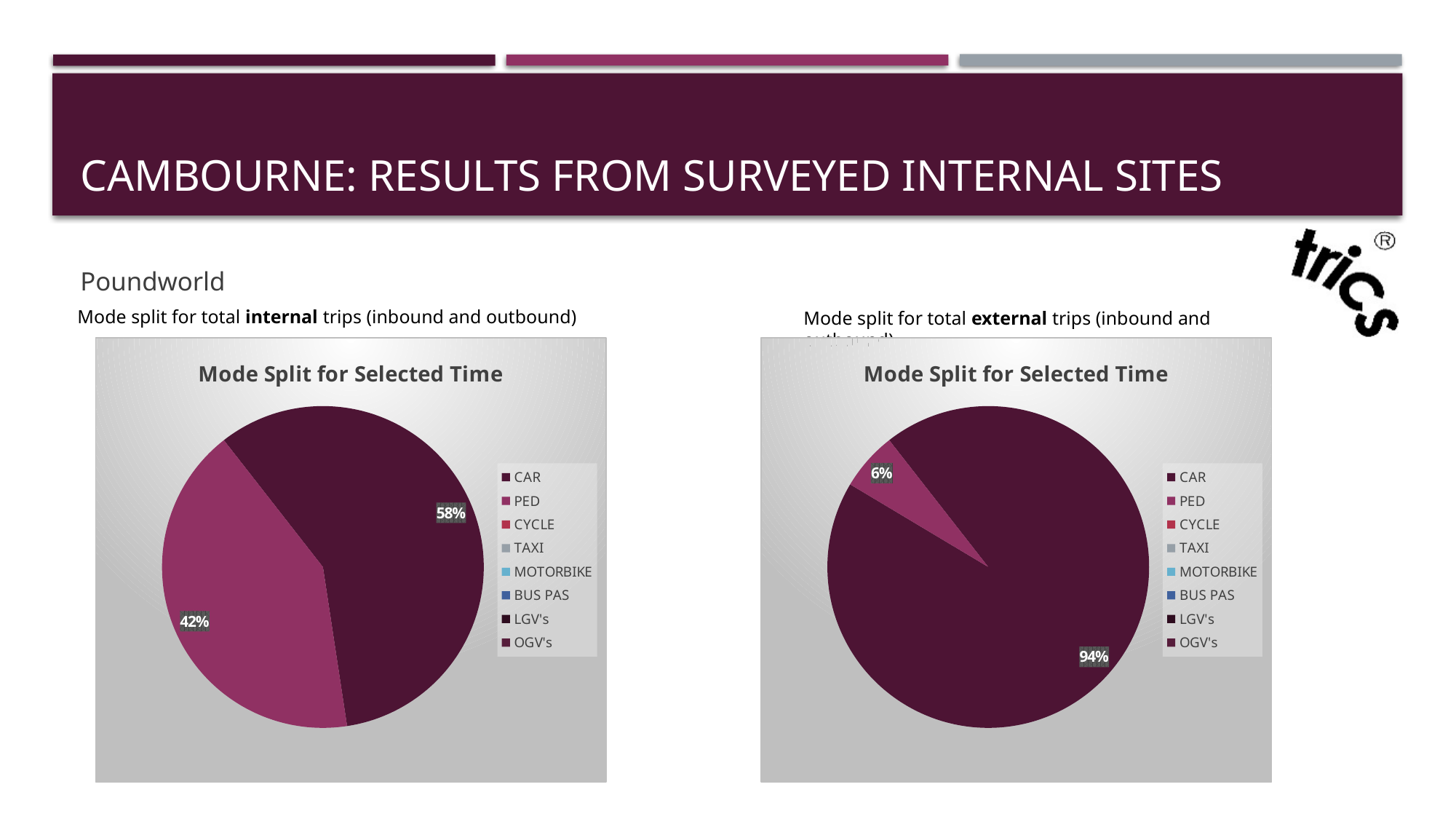
In the right chart (external trips), which mode has the smallest visible share? PED Which chart shows a larger CAR share, the internal trips chart or the external trips chart? External trips chart How many entries does the legend of the left chart list? 8 In the right chart (external trips), what share of trips is by PED? 6% In the left chart (internal trips), which mode has the largest share? CAR In the right chart (external trips), what share of trips is by CAR? 94% What type of chart is used on this slide? Pie chart In the left chart (internal trips), what share of trips is by PED? 42% In the left chart (internal trips), what share of trips is by CAR? 58% What is the title shown inside each chart? Mode Split for Selected Time In the right chart (external trips), what is the difference in percentage points between the CAR and PED shares? 88 In the left chart (internal trips), what is the difference in percentage points between the CAR and PED shares? 16